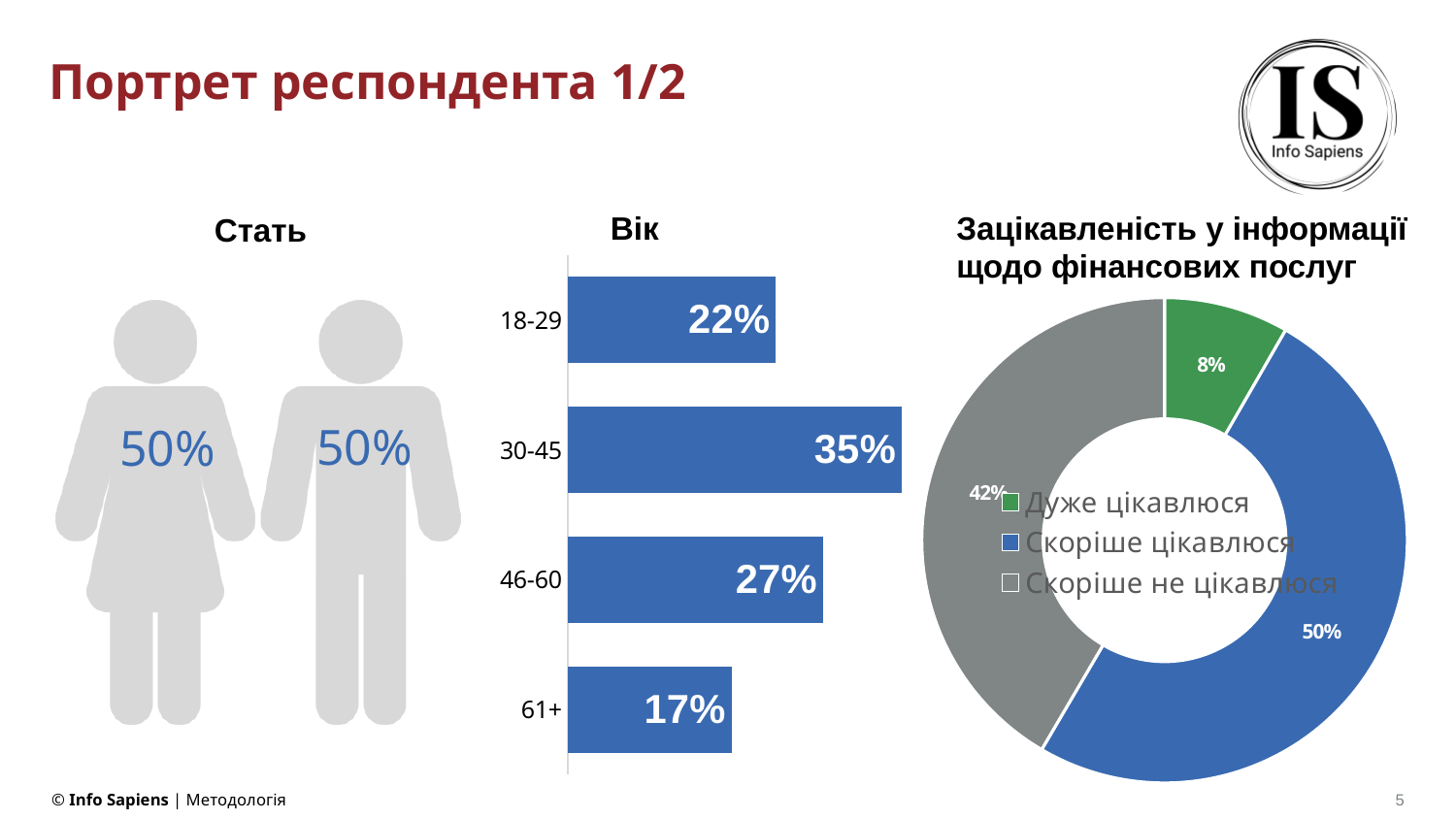
In the "Вік" chart, what is the value for the 61+ age group? 17% How many categories does the legend of the "Зацікавленість у інформації щодо фінансових послуг" chart list? 3 In the "Зацікавленість у інформації щодо фінансових послуг" chart, what colour is the "Дуже цікавлюся" segment? Green How many age groups are shown in the "Вік" chart? 4 In the "Вік" chart, which age group has the lowest value? 61+ In the "Вік" chart, what is the difference between the values for 46-60 and 18-29? 5% What kind of chart is the "Вік" chart? Bar chart In the "Зацікавленість у інформації щодо фінансових послуг" chart, what share is "Скоріше цікавлюся"? 50% In the "Вік" chart, which is larger: the value for 18-29 or the value for 46-60? 46-60 In the "Вік" chart, which age group has the highest value? 30-45 In the "Зацікавленість у інформації щодо фінансових послуг" chart, which category has the smallest share? Дуже цікавлюся In the "Вік" chart, what is the value for the 30-45 age group? 35%